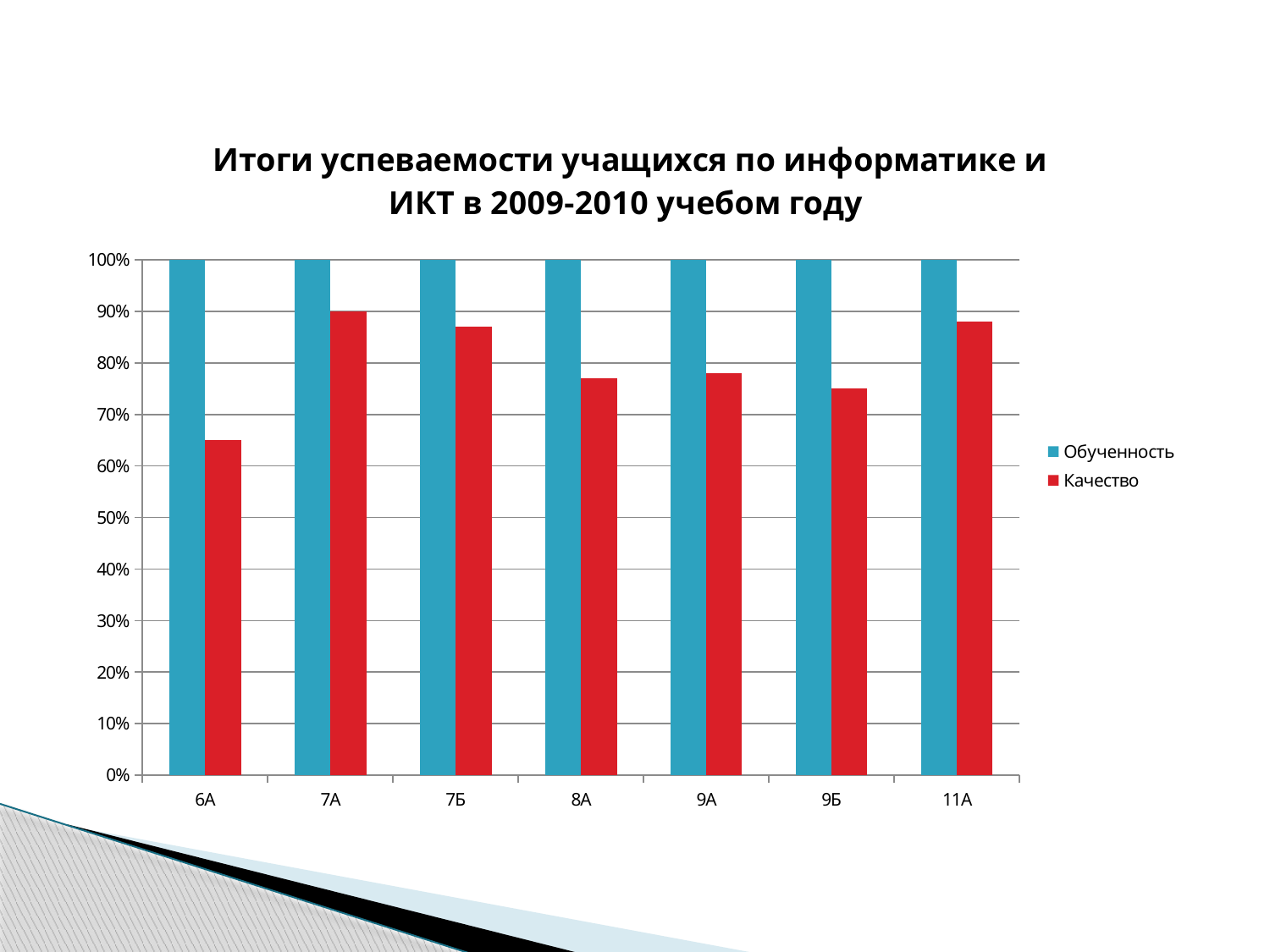
What is the Обученность value for class 6А? 100% Which class has the larger Качество value, 6А or 7А? 7А Which class has the lowest Качество value? 6А Is the Качество value for class 11А greater or less than 80%? greater How many series does the legend list? 2 Is the Качество value for class 7Б greater or less than 80%? greater Is the Качество value for class 9Б greater or less than 80%? less Which series is shown in red in the legend? Качество What is the Обученность value for class 8А? 100% How many classes (categories) are shown on the x axis? 7 What kind of chart is shown on the slide? bar chart